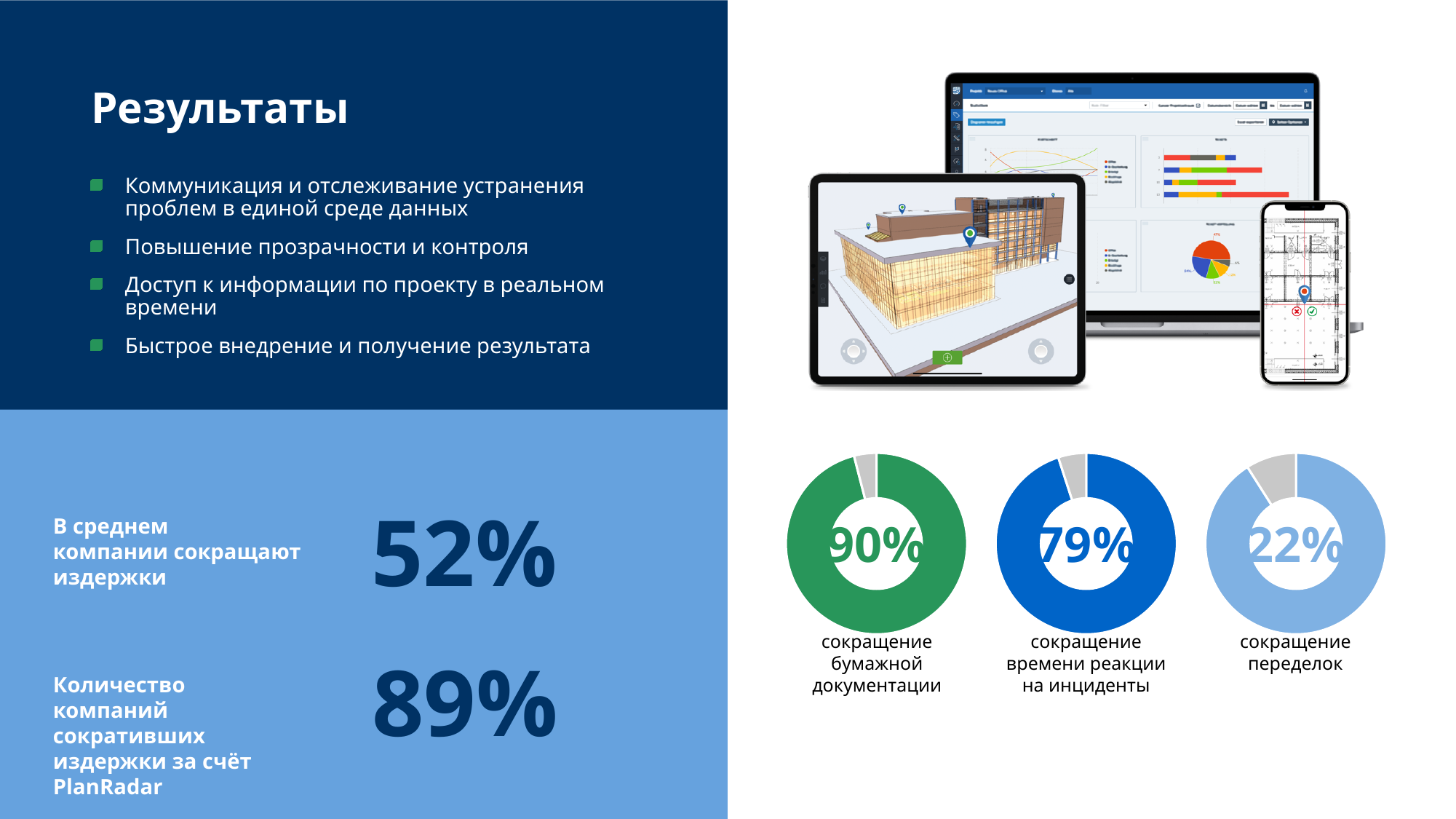
Among the three donut charts on the right of the slide, which category has the lowest printed value? сокращение переделок What colour is the donut chart labelled 'сокращение времени реакции на инциденты'? dark blue What is the difference between the value in the green donut chart (90%) and the value in the dark blue donut chart (79%)? 11% What colour is the donut chart that shows 90%? green What is the difference between the value in the dark blue donut chart (79%) and the value in the light blue donut chart (22%)? 57% Among the three donut charts on the right of the slide, which category has the highest printed value? сокращение бумажной документации How many donut charts are shown in the lower right part of the slide? 3 What value is shown in the light blue donut chart labelled 'сокращение переделок'? 22% Which is larger: the value for 'сокращение бумажной документации' or the value for 'сокращение переделок'? сокращение бумажной документации What value is shown in the green donut chart labelled 'сокращение бумажной документации'? 90% What value is shown in the dark blue donut chart labelled 'сокращение времени реакции на инциденты'? 79% What kind of chart is used to display the 90%, 79% and 22% values on the slide? donut chart